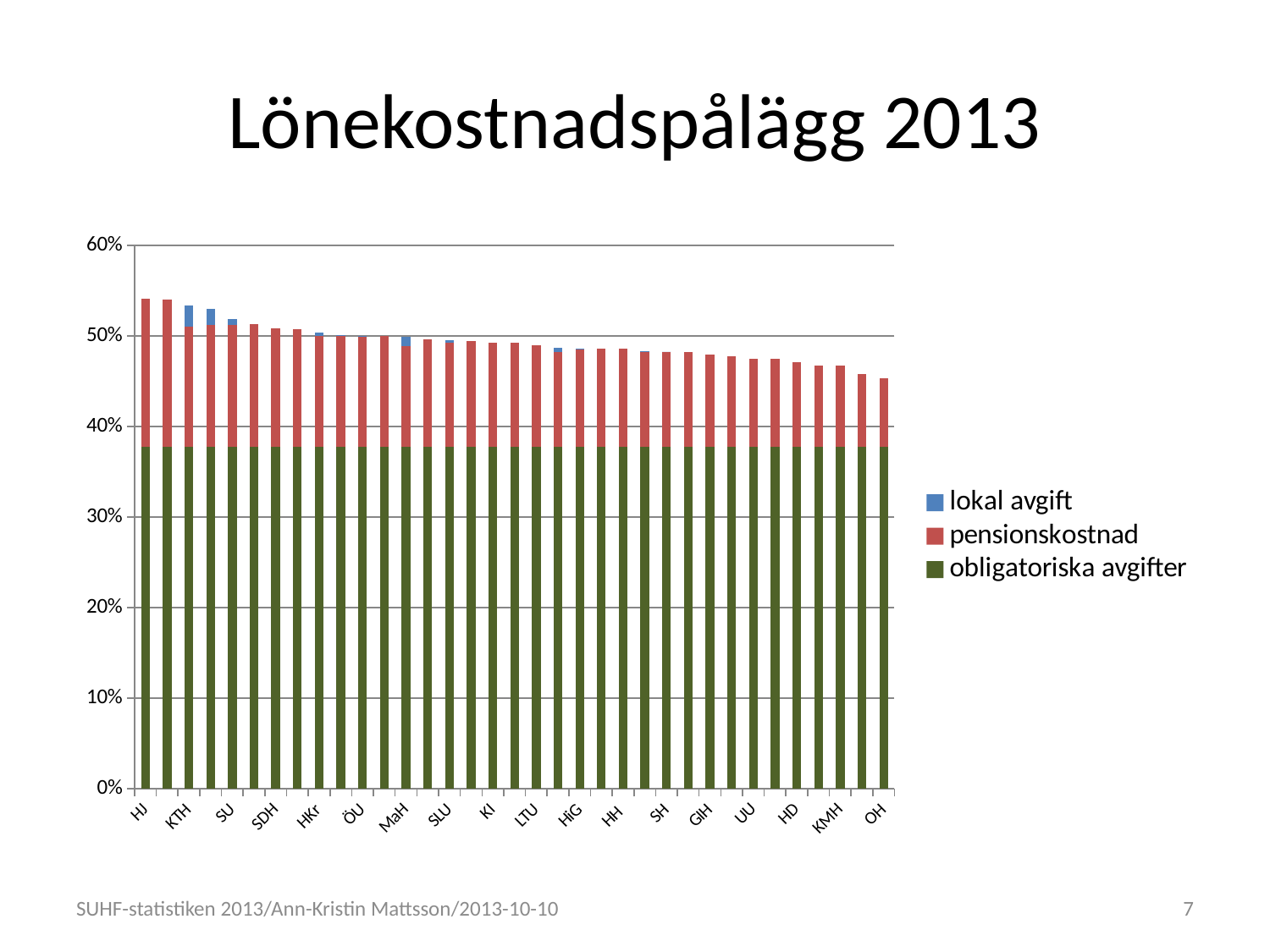
What is the title of the chart? Lönekostnadspålägg 2013 Which has the larger total value, KTH or UU? KTH Is the total value for HJ greater or less than 50%? greater Do the total bar heights rise or fall from left to right along the x axis? fall How many series does the legend list? 3 Is the total value for OH greater or less than 50%? less Is the total value for UU greater or less than 50%? less What kind of chart is shown on the slide? stacked bar chart Which has the larger total value, HJ or OH? HJ Which series is shown in green at the bottom of each bar? obligatoriska avgifter